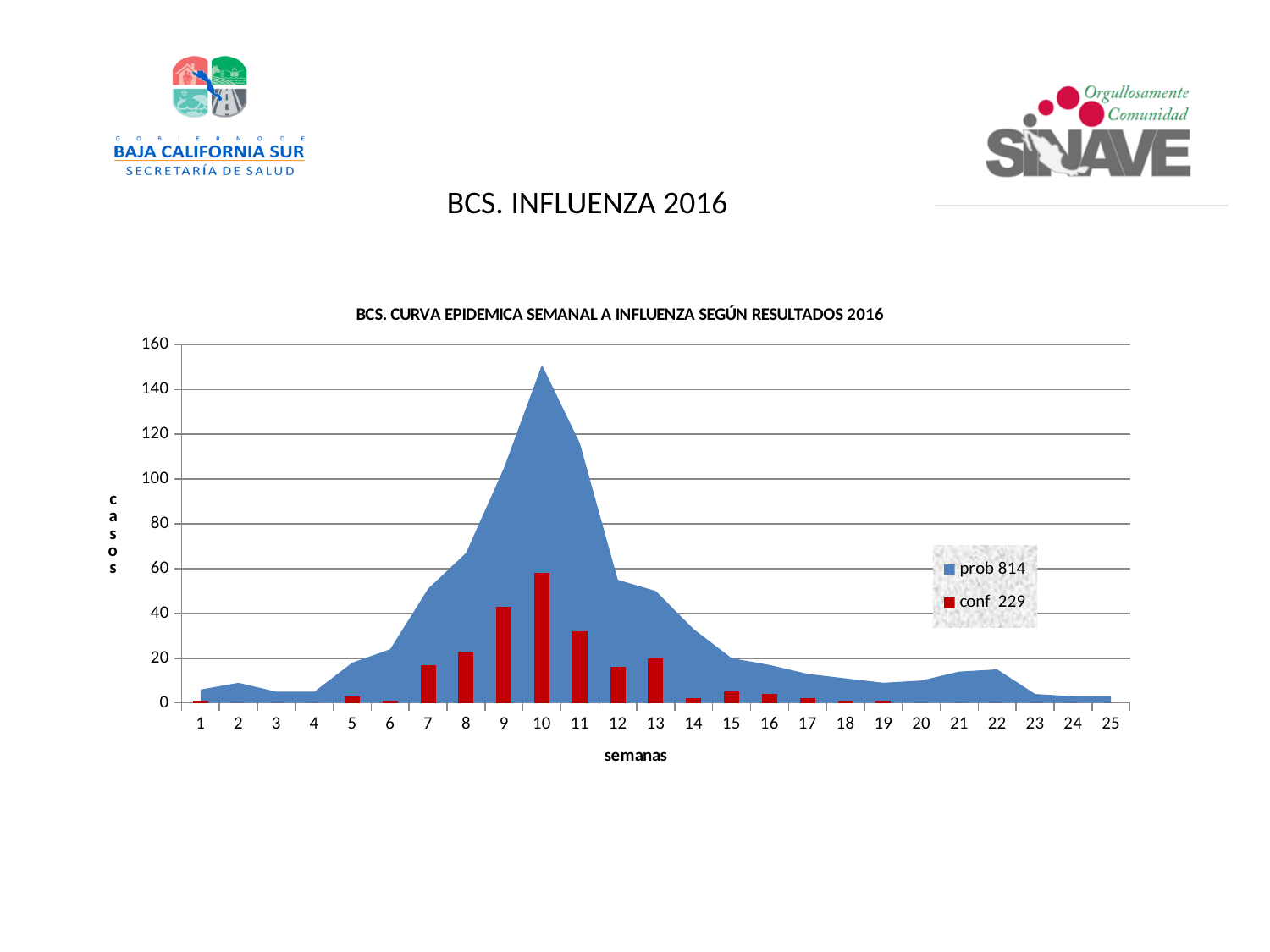
How many series does the legend list? 2 How many weeks (semanas) are shown on the x axis? 25 In which week does the prob series reach its highest value? 10 Which is larger, the conf value in week 9 or the conf value in week 11? week 9 Is the value of the conf series in week 11 greater or less than 20? greater Is the value of the prob series in week 22 greater or less than 20? less Does the prob series rise or fall from week 10 to week 15? fall Is the value of the conf series in week 10 greater or less than 40? greater What is the title of the chart? BCS. CURVA EPIDEMICA SEMANAL A INFLUENZA SEGÚN RESULTADOS 2016 What are the two entries in the chart legend? prob 814 and conf 229 In which week does the conf series reach its highest value? 10